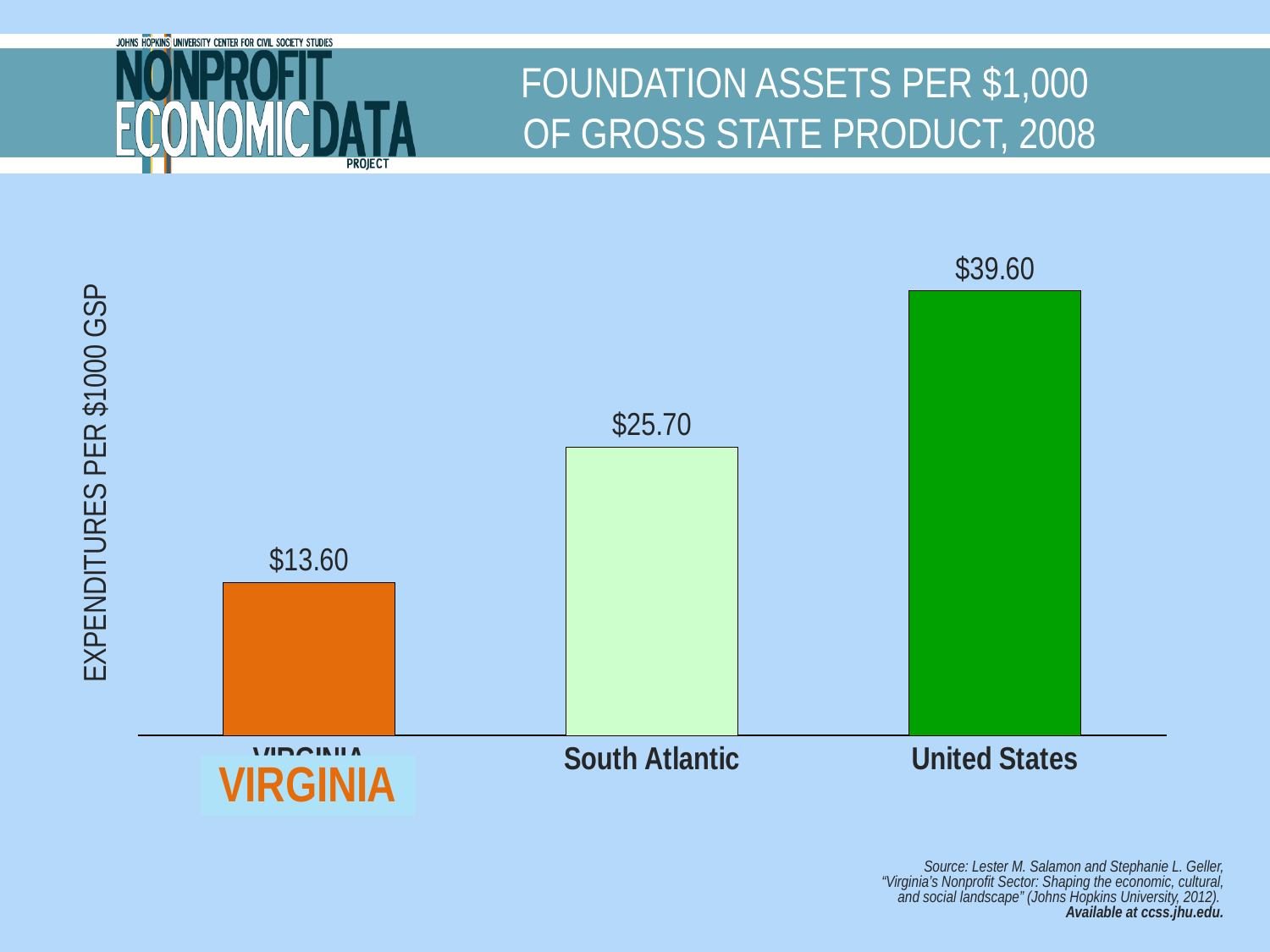
Which is larger, the value for South Atlantic or the value for Virginia? South Atlantic Which category has the lowest value? Virginia What is the value for United States? $39.60 What is the difference between the South Atlantic and Virginia values? $12.10 What is the value for South Atlantic? $25.70 What is the value for Virginia? $13.60 What kind of chart is shown on the slide? Bar chart What is the difference between the United States and Virginia values? $26.00 Do the values rise or fall from left to right across the categories? Rise Which category has the highest value? United States What is the title of the chart? Foundation Assets per $1,000 of Gross State Product, 2008 How many categories are shown in the chart? 3